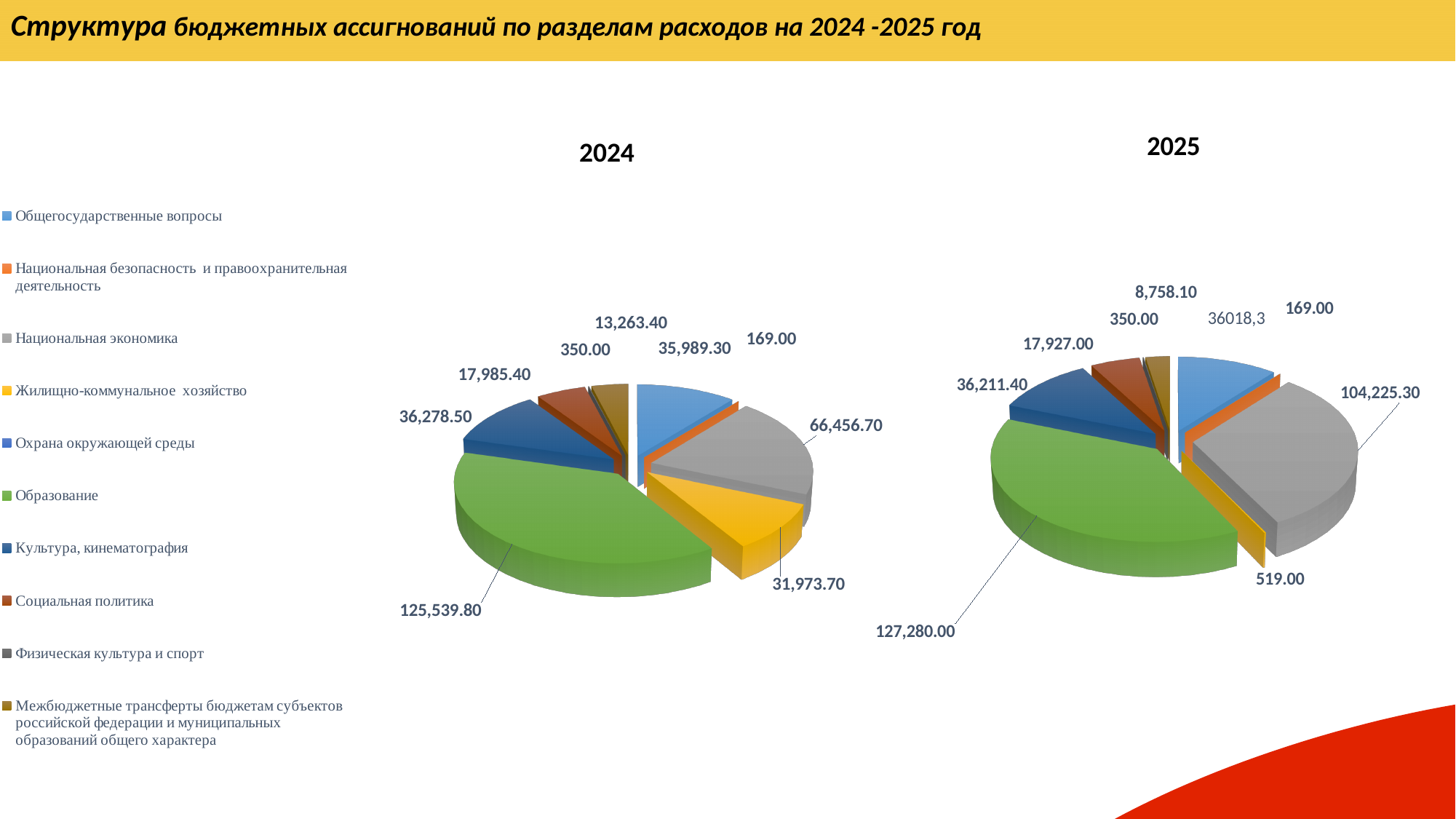
What is the title of the slide? Структура бюджетных ассигнований по разделам расходов на 2024 -2025 год In the 2024 pie chart, what is the value for Национальная экономика (grey slice)? 66,456.70 How many categories does the legend list? 10 In the 2024 pie chart, what is the value for Жилищно-коммунальное хозяйство (yellow slice)? 31,973.70 What type of chart is used for the 2024 and 2025 data on this slide? Pie chart In the 2024 pie chart, what is the value for Образование? 125,539.80 In the 2024 pie chart, which category has the largest slice? Образование In the 2024 pie chart, what is the value for Культура, кинематография (dark blue slice)? 36,278.50